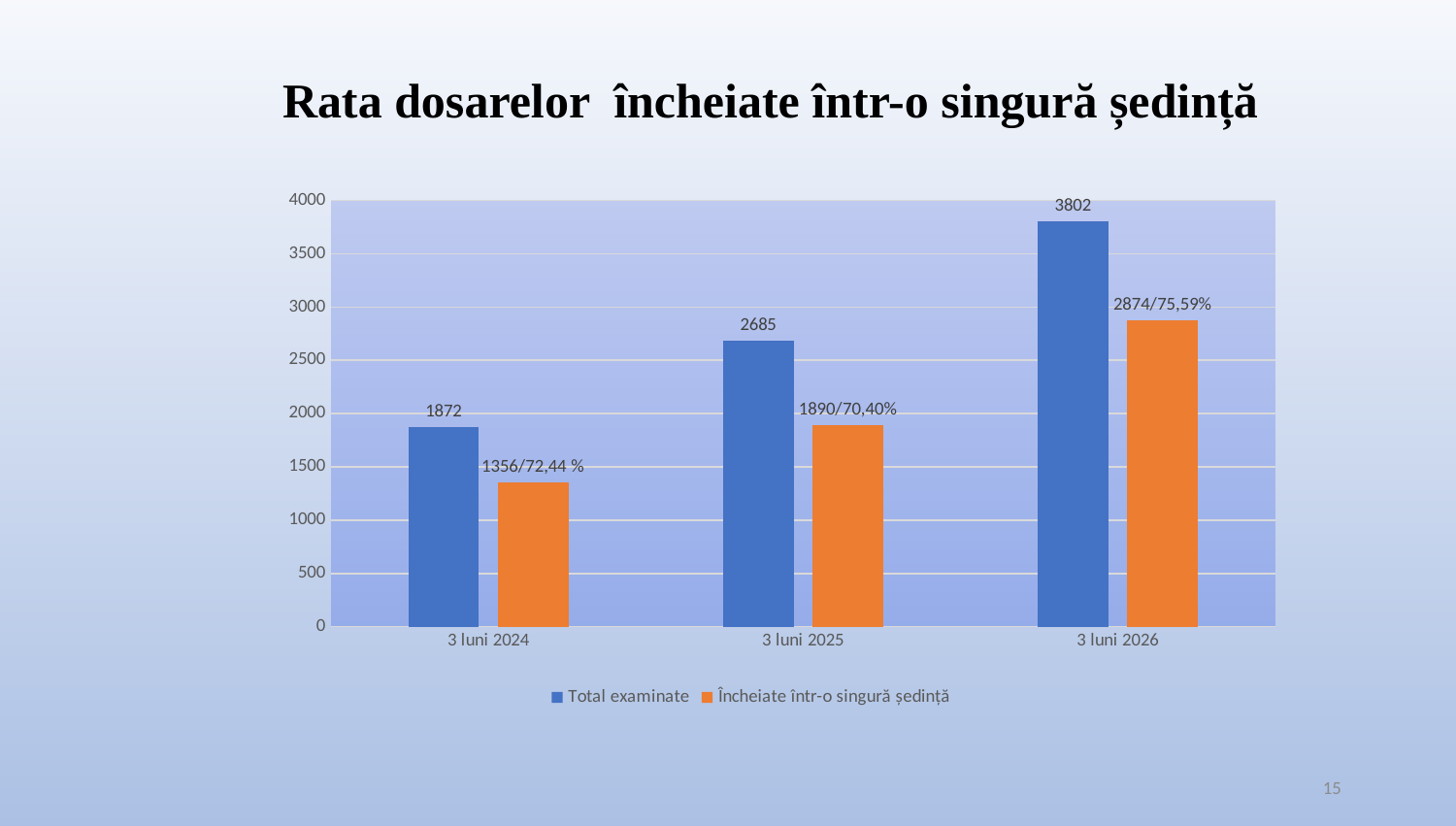
How many series does the legend list? 2 Is the "Total examinate" value for 3 luni 2025 greater or less than 2500? greater What is the data label on the "Încheiate într-o singură ședință" bar for 3 luni 2025? 1890/70,40% Which is larger: "Total examinate" for 3 luni 2025 or "Încheiate într-o singură ședință" for 3 luni 2026? Încheiate într-o singură ședință for 3 luni 2026 What is the value of "Total examinate" for 3 luni 2026? 3802 How many periods are shown on the x axis? 3 What is the data label on the "Încheiate într-o singură ședință" bar for 3 luni 2024? 1356/72,44 % Which period has the lowest "Total examinate" value? 3 luni 2024 Does the "Total examinate" value rise or fall from 3 luni 2024 to 3 luni 2026? rise What is the difference between "Total examinate" for 3 luni 2026 and 3 luni 2025? 1117 Which period has the highest "Total examinate" value? 3 luni 2026 What is the value of "Total examinate" for 3 luni 2024? 1872